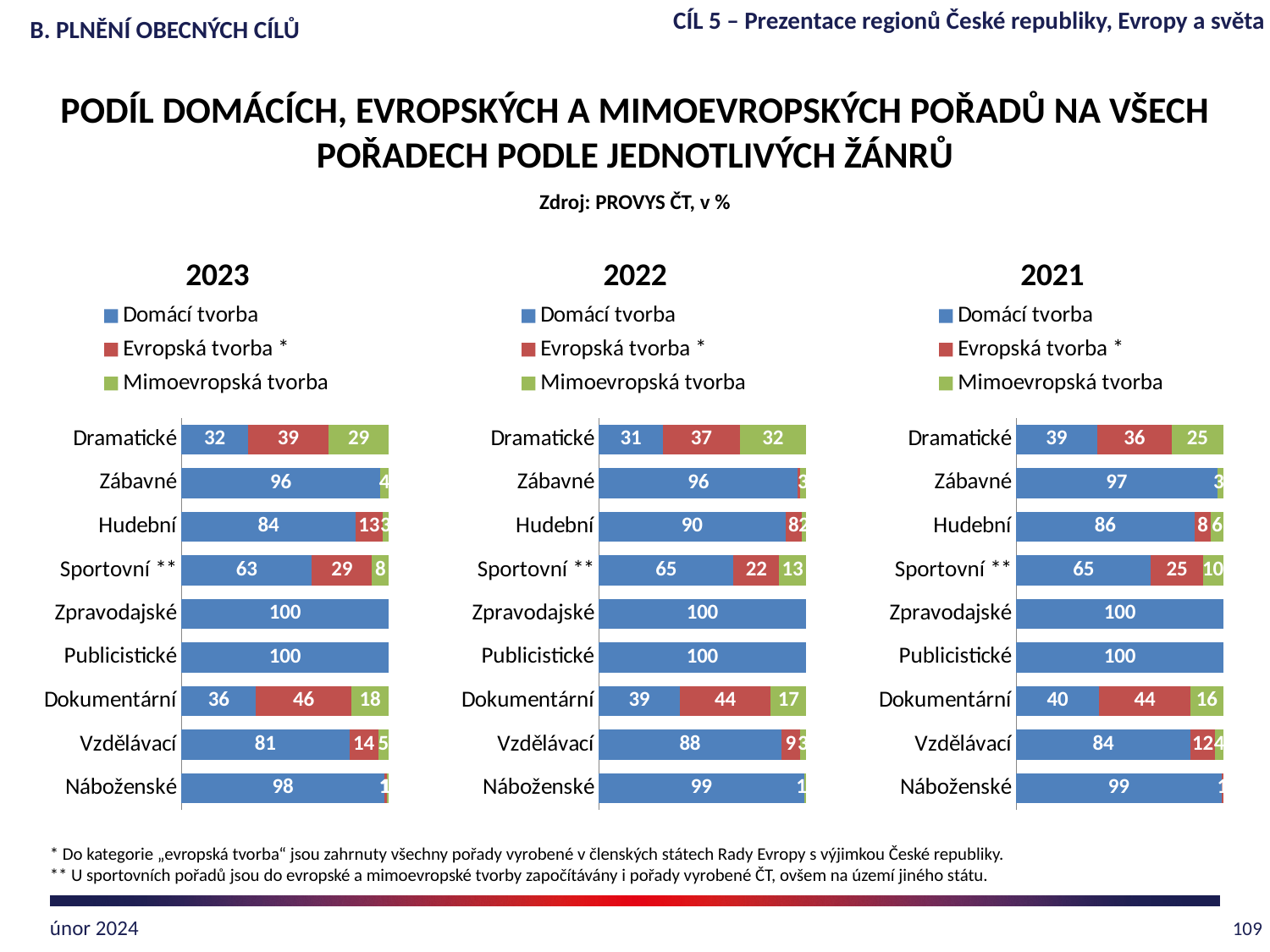
In the 2022 chart, what is the value of Domácí tvorba for Sportovní **? 65 In the 2023 chart, which is larger for Dokumentární: Domácí tvorba or Evropská tvorba *? Evropská tvorba * In the 2021 chart, what is the difference between the Domácí tvorba values for Hudební and Vzdělávací? 2 In the 2022 chart, what is the value of Evropská tvorba * for Dokumentární? 44 In the 2023 chart, which category has the lowest value of Domácí tvorba? Dramatické In the 2022 chart, which category has the highest value of Evropská tvorba *? Dokumentární How many series does the legend of the 2021 chart list? 3 What type of chart is the 2023 chart? Stacked bar chart How many categories are shown in the 2022 chart? 9 In the 2021 chart, what is the value of Mimoevropská tvorba for Sportovní **? 10 What is the source stated below the slide title? PROVYS ČT, v % In the 2023 chart, what is the value of Domácí tvorba for Dramatické? 32